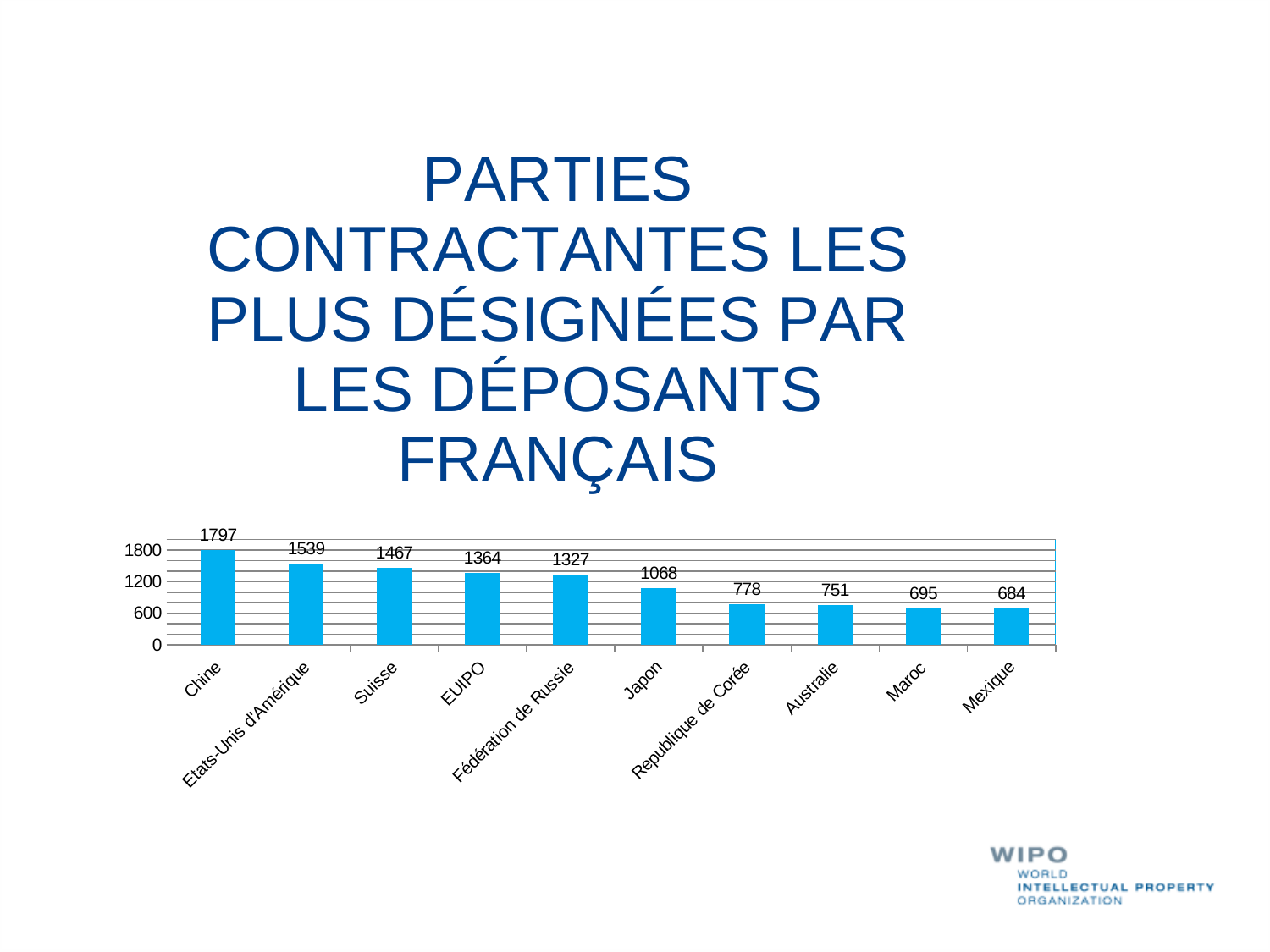
Which is larger, the value for Suisse or the value for EUIPO? Suisse Is the value for Australie greater or less than 1200? less What kind of chart is shown on the slide? bar chart Which category has the highest value? Chine Do the values rise or fall from left to right along the x axis? fall What is the value for Fédération de Russie? 1327 How many categories are shown on the x axis? 10 What is the difference between the values for Chine and Etats-Unis d'Amérique? 258 Which category has the lowest value? Mexique What is the difference between the values for Japon and Republique de Corée? 290 What is the value for Maroc? 695 What is the value for Chine? 1797